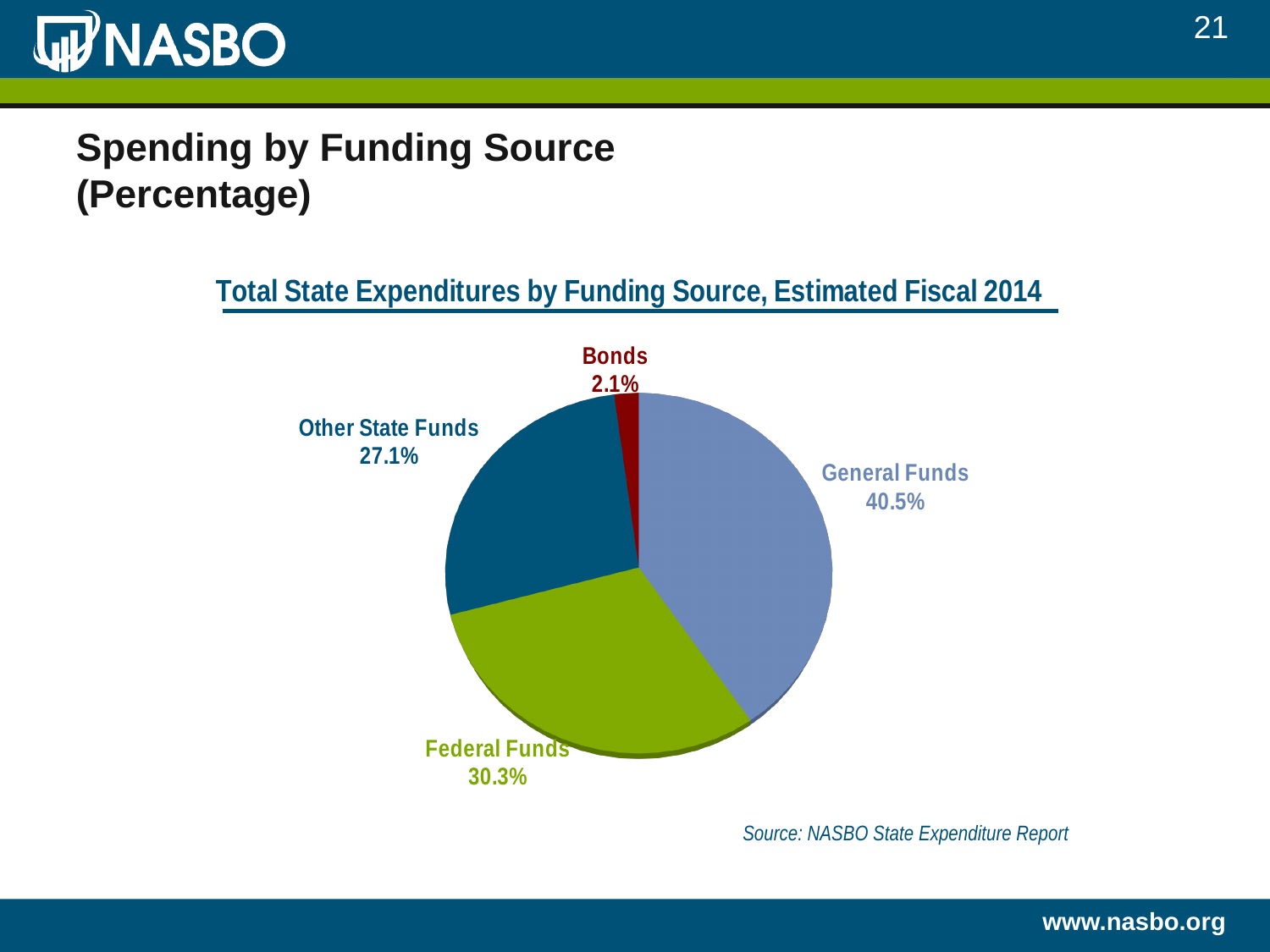
What colour is the Bonds slice of the pie chart? dark red What percentage of total state expenditures comes from General Funds? 40.5% Which funding source has the largest share of total state expenditures? General Funds What percentage of total state expenditures comes from Other State Funds? 27.1% What type of chart is shown on the slide? pie chart Which funding source has the smallest share of total state expenditures? Bonds What percentage of total state expenditures comes from Federal Funds? 30.3% What is the difference in percentage points between General Funds and Federal Funds? 10.2 How many funding source categories are shown in the pie chart? 4 What is the title of the chart? Total State Expenditures by Funding Source, Estimated Fiscal 2014 Which is larger, the share for Federal Funds or the share for Other State Funds? Federal Funds What percentage of total state expenditures comes from Bonds? 2.1%